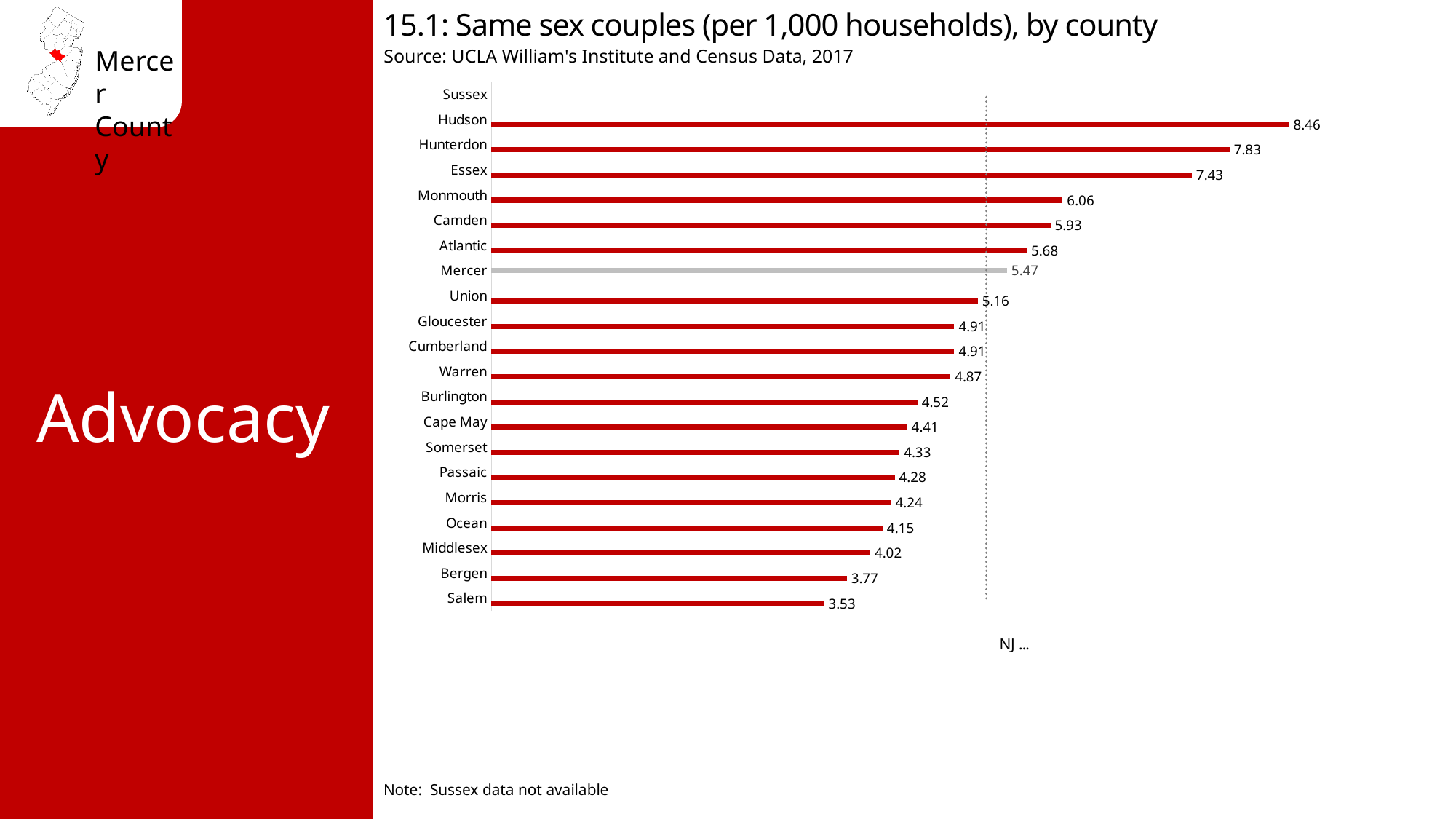
What is the difference between the values for Hudson and Hunterdon? 0.63 Which county's bar is shown in grey rather than red? Mercer What kind of chart is shown? Bar chart What is the value for Salem? 3.53 Which is larger, the value for Bergen or the value for Middlesex? Middlesex What is the difference between the values for Mercer and Salem? 1.94 How many counties are listed on the chart's axis? 21 Which county has the lowest plotted value? Salem What is the value for Hudson? 8.46 Which is larger, the value for Camden or the value for Atlantic? Camden Which county has the highest value? Hudson What is the value for Mercer? 5.47